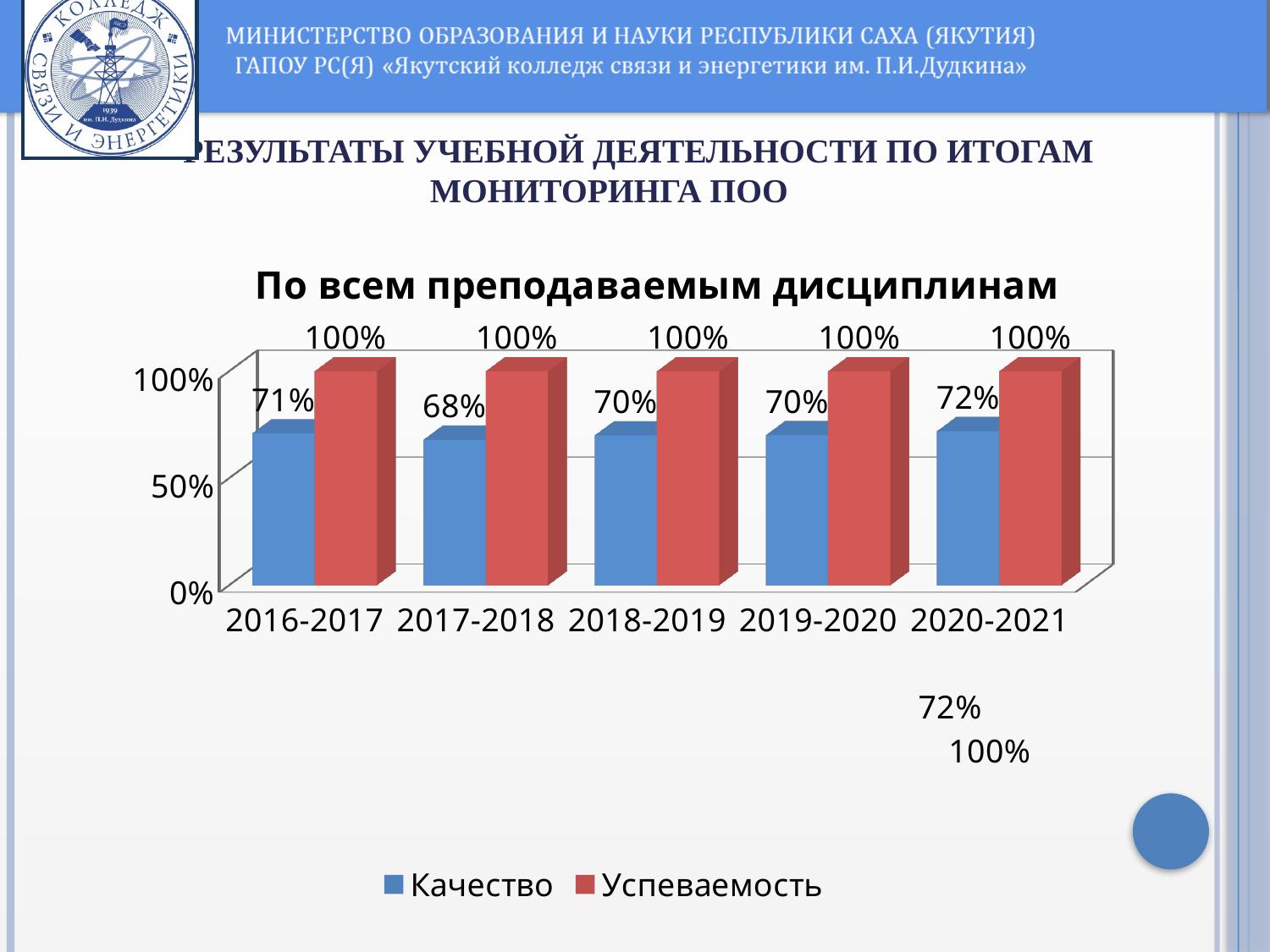
What kind of chart is shown? Bar chart What is the value of Успеваемость for 2018-2019? 100% What is the difference in Качество between 2020-2021 and 2017-2018? 4% Which year has the highest Качество value? 2020-2021 How many years are shown on the x axis? 5 What is the value of Качество for 2017-2018? 68% How many series does the legend list? 2 What is the value of Качество for 2020-2021? 72% Which is larger for 2016-2017: Качество or Успеваемость? Успеваемость What is the value of Качество for 2016-2017? 71% Which year has the lowest Качество value? 2017-2018 What is the difference between Успеваемость and Качество for 2019-2020? 30%